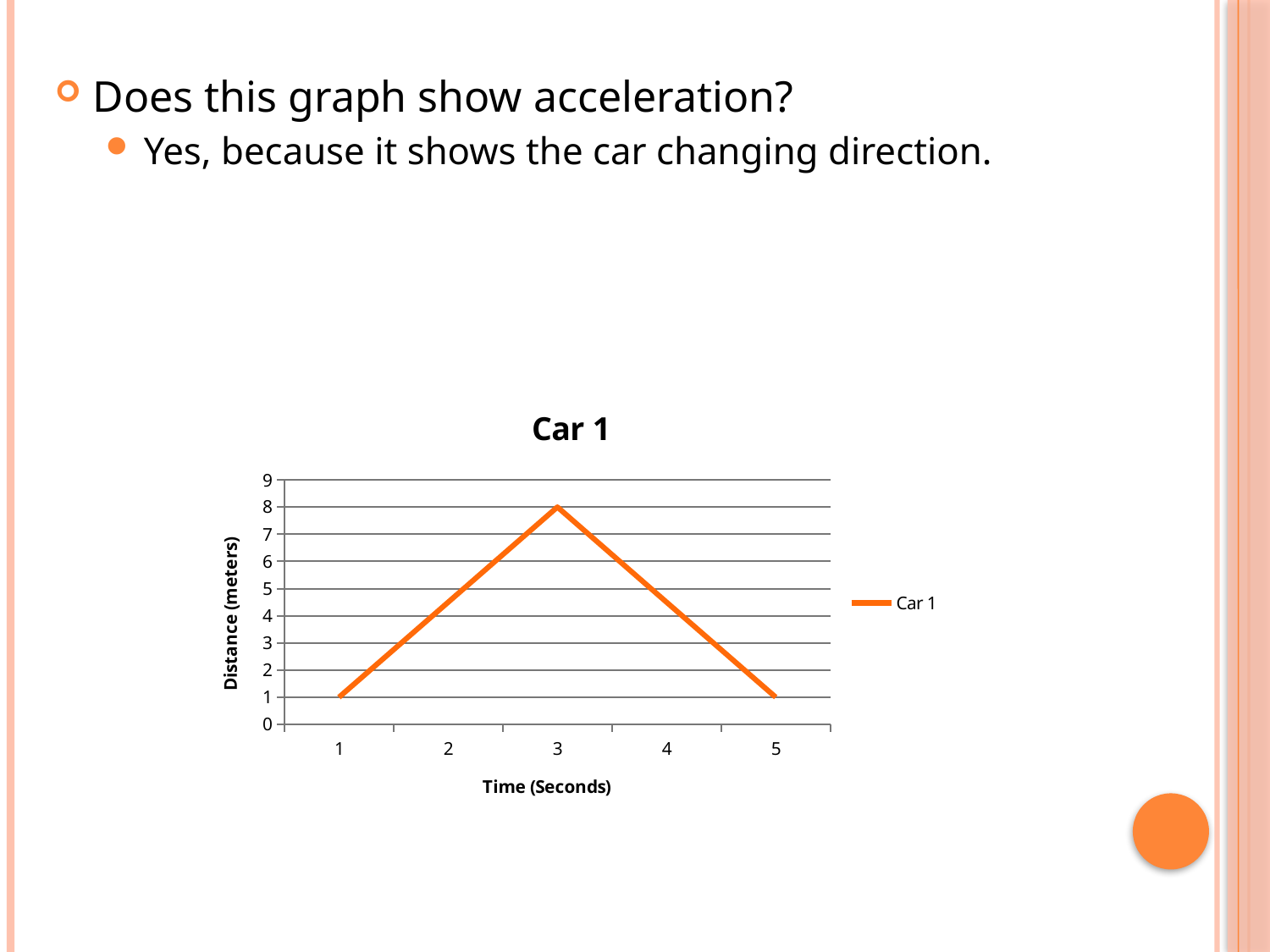
At which time does Car 1 reach its highest distance? 3 What is the distance for Car 1 at 1 second? 1 Which has the larger distance value: 3 seconds or 5 seconds? 3 seconds What is the distance for Car 1 at 5 seconds? 1 What is the distance for Car 1 at 3 seconds? 8 What kind of chart is shown on the slide? line chart Is the distance for Car 1 at 4 seconds greater or less than 6? less How many series does the legend list? 1 How many time points are shown on the x axis? 5 Between 3 seconds and 5 seconds, does the distance rise or fall? fall What is the difference between the distance at 3 seconds and the distance at 1 second? 7 Is the distance for Car 1 at 2 seconds greater or less than 3? greater